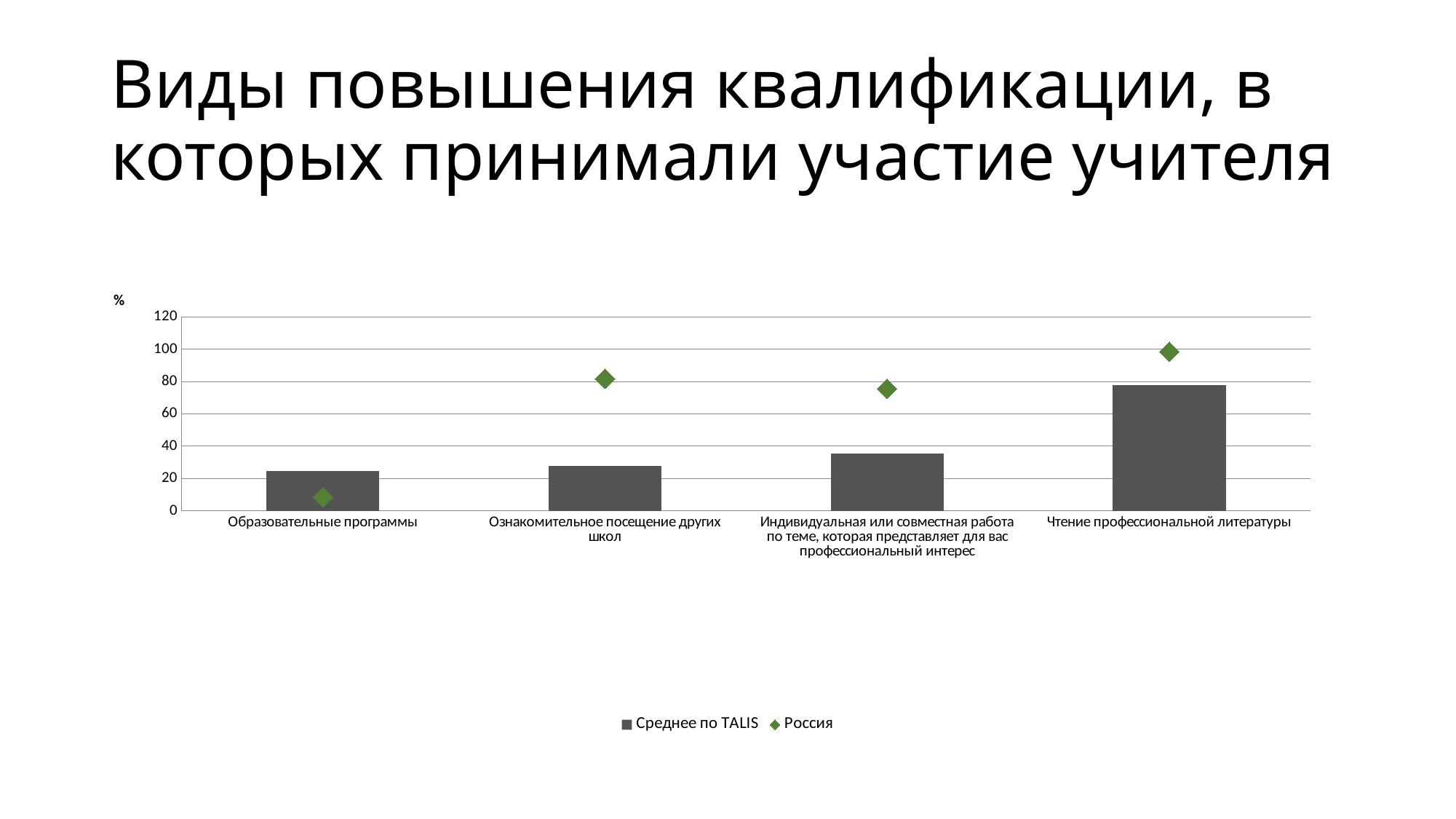
Is the value for Среднее по TALIS in Индивидуальная или совместная работа по теме, которая представляет для вас профессиональный интерес greater or less than 40? less What kind of chart is used to show the Среднее по TALIS series? bar chart How many series does the legend list? 2 How many categories are shown on the x axis? 4 Which category has the highest value for Россия? Чтение профессиональной литературы For Ознакомительное посещение других школ, which is larger: Среднее по TALIS or Россия? Россия Do the Среднее по TALIS values rise or fall from left to right along the x axis? rise Is the value for Россия in Образовательные программы greater or less than 20? less Is the value for Россия in Чтение профессиональной литературы greater or less than 80? greater Which category has the lowest value for Россия? Образовательные программы Which category has the highest value for Среднее по TALIS? Чтение профессиональной литературы For Образовательные программы, which is larger: Среднее по TALIS or Россия? Среднее по TALIS